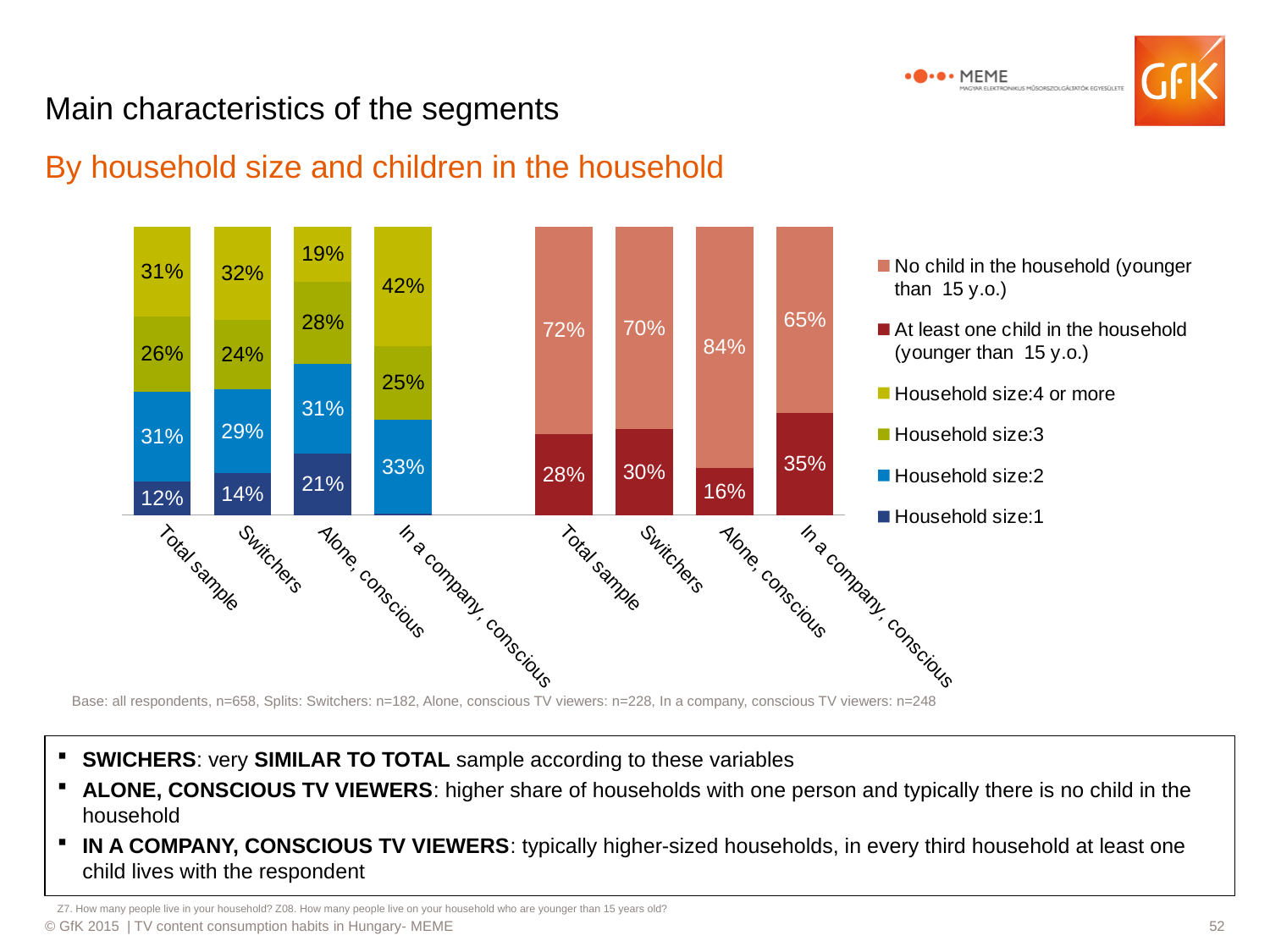
In the left chart (household size), which category has the lowest value for Household size:4 or more? Alone, conscious How many entries does the legend on the slide list? 6 What colour represents Household size:2 in the legend? Blue What type of chart is used on this slide? Stacked bar chart In the left chart (household size), which is larger: Household size:1 for Alone, conscious or Household size:1 for Switchers? Alone, conscious In the left chart (household size), what is the value for Household size:4 or more for In a company, conscious? 42% In the right chart (children in the household), what is the share of No child in the household for Alone, conscious? 84% In the left chart (household size), what is the value for Household size:1 for the Total sample? 12% How many categories are shown on the x axis of the left chart (household size)? 4 In the right chart (children in the household), what is the total of the two segments for Switchers? 100% In the right chart (children in the household), which category has the highest share of At least one child in the household? In a company, conscious In the right chart (children in the household), what is the difference between the No child share for Alone, conscious and for In a company, conscious? 19%